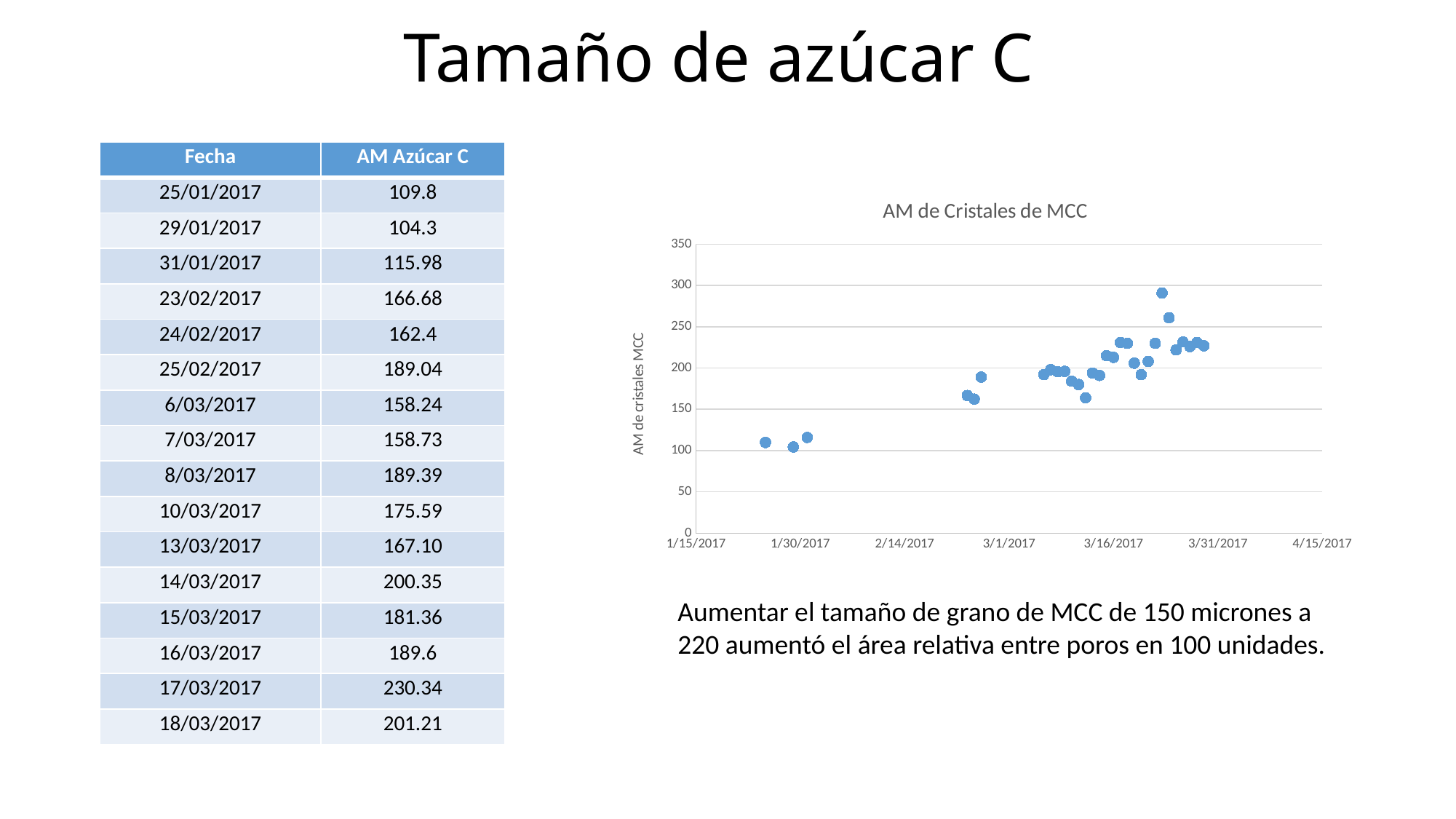
Are the earliest plotted points (near the end of January 2017) greater or less than 150? less Are the points plotted near 3/31/2017 greater or less than 200? greater What is the label on the vertical axis of the chart? AM de cristales MCC What is the title of the chart? AM de Cristales de MCC Are the points plotted near 3/1/2017 greater or less than 150? greater Which group of points is higher on the chart: those near 1/30/2017 or those near 3/31/2017? those near 3/31/2017 Do the plotted values generally rise or fall from left to right along the x axis? rise What kind of chart is shown on the slide? scatter chart